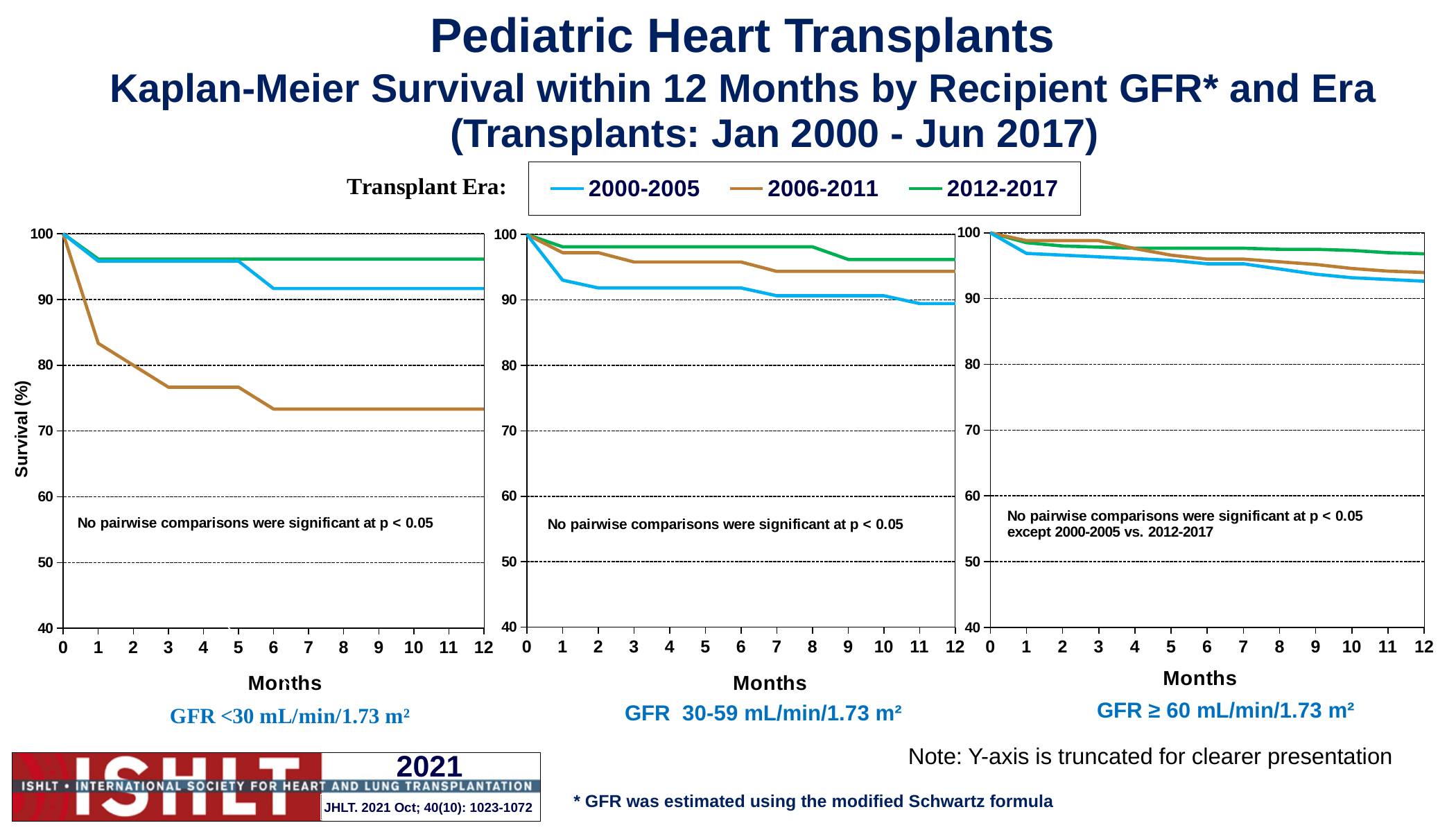
In the GFR <30 mL/min/1.73 m² chart, does survival for 2006-2011 rise or fall as months increase? fall In the GFR 30-59 mL/min/1.73 m² chart, which transplant era has the lowest survival at 12 months? 2000-2005 In the GFR <30 mL/min/1.73 m² chart, which era has higher survival at 12 months, 2000-2005 or 2006-2011? 2000-2005 In the GFR ≥ 60 mL/min/1.73 m² chart, is the survival for 2000-2005 at 12 months greater or less than 90? greater In the GFR <30 mL/min/1.73 m² chart, is the survival for 2006-2011 at 12 months greater or less than 80? less In the GFR 30-59 mL/min/1.73 m² chart, is the survival for 2000-2005 at month 3 greater or less than 90? greater In the GFR <30 mL/min/1.73 m² chart, which transplant era has the lowest survival at 12 months? 2006-2011 In the GFR 30-59 mL/min/1.73 m² chart, what is the survival value for all eras at month 0? 100 In the GFR ≥ 60 mL/min/1.73 m² chart, which transplant era has the highest survival at 12 months? 2012-2017 What kind of chart is used in the GFR <30 mL/min/1.73 m² panel? line chart How many transplant eras does the legend list? 3